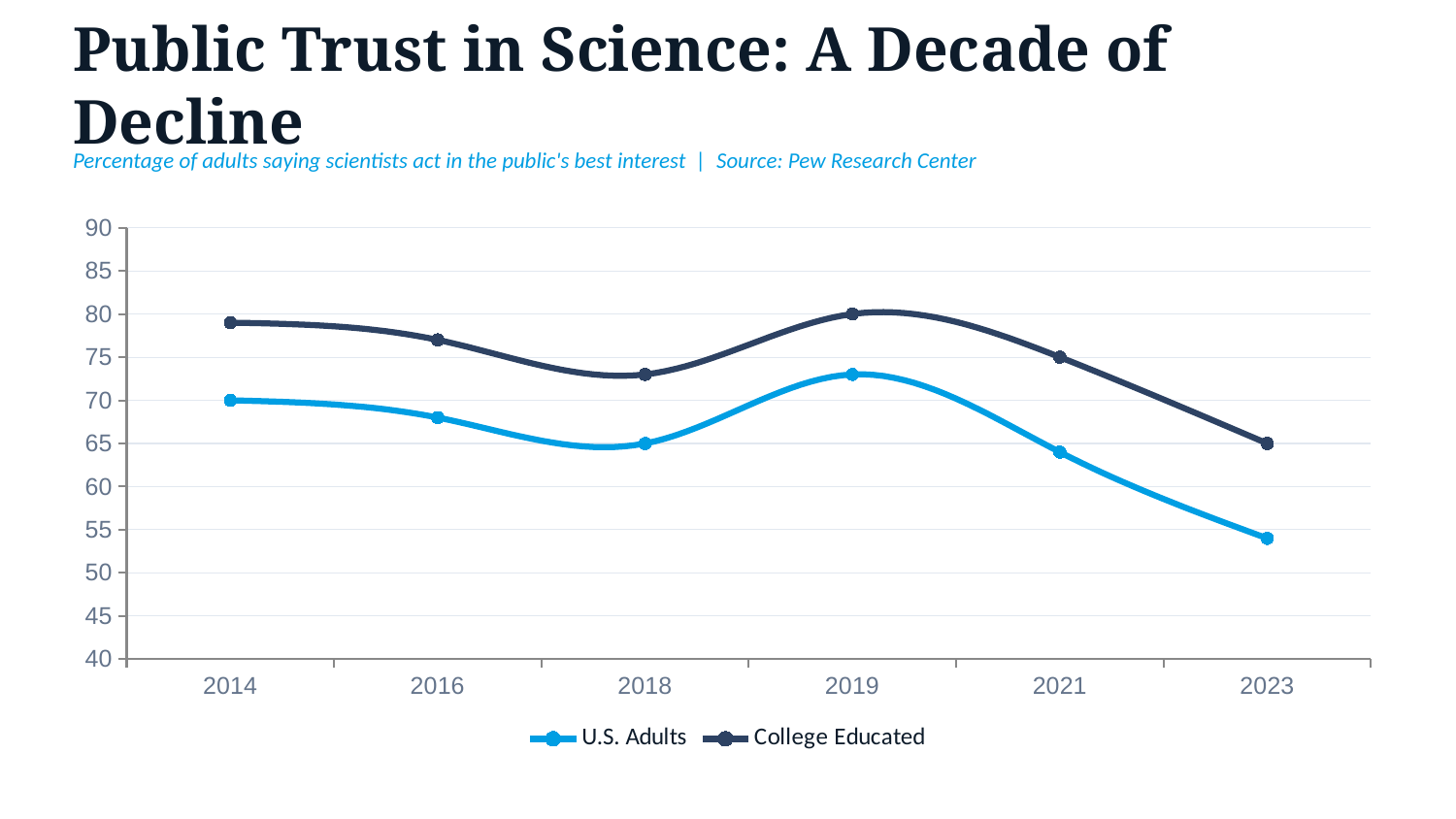
Is the value for College Educated in 2014 greater or less than 75? greater What source is cited for the chart data? Pew Research Center Does the U.S. Adults line rise or fall between 2019 and 2023? Fall Which series is higher in 2023, U.S. Adults or College Educated? College Educated What is the title of the chart on the slide? Public Trust in Science: A Decade of Decline How many series does the legend list? 2 How many years are plotted along the x axis? 6 In which year is the U.S. Adults value lowest? 2023 Is the value for U.S. Adults in 2021 greater or less than 60? greater What kind of chart is shown on the slide? Line chart In which year is the College Educated value highest? 2019